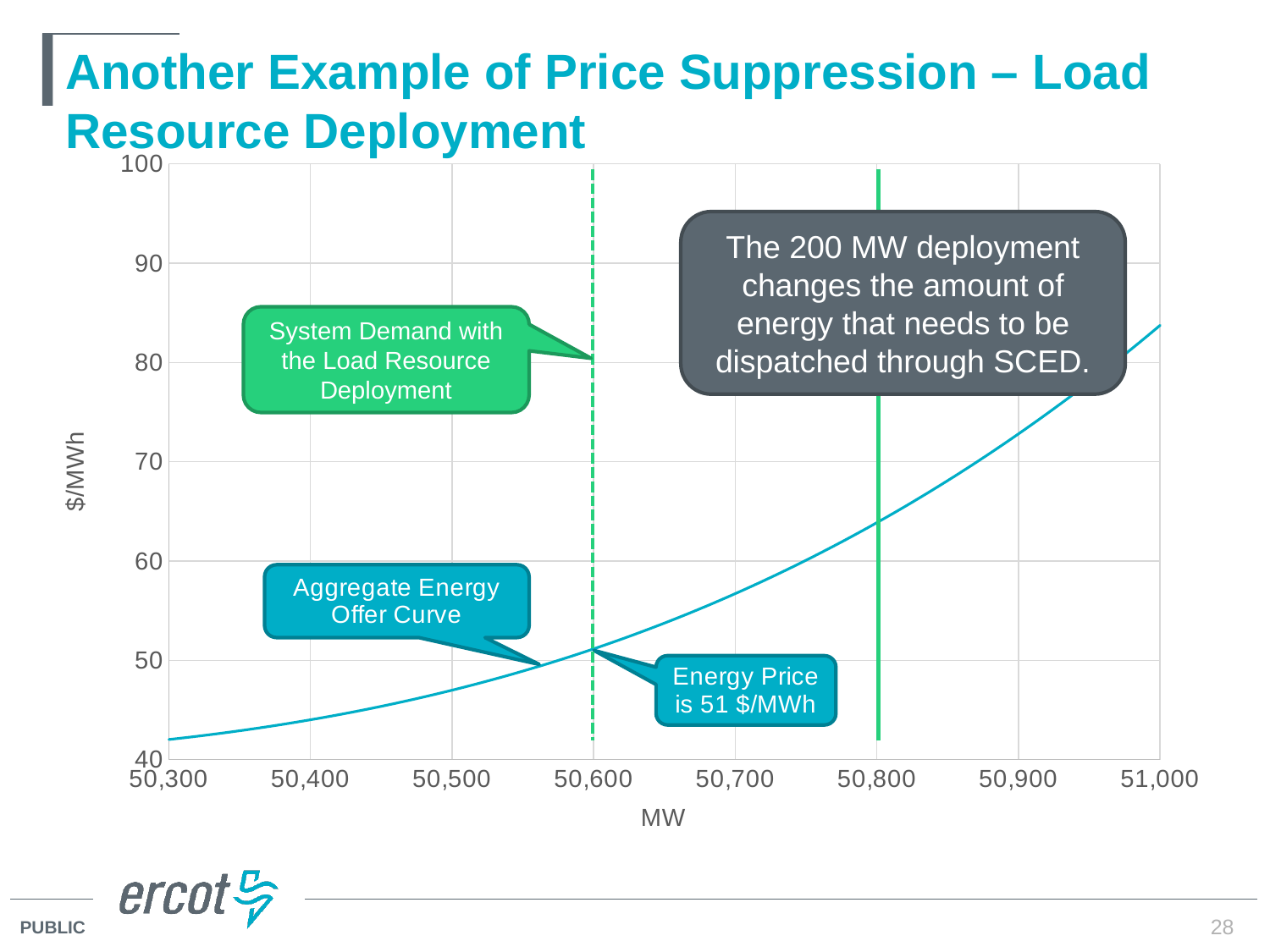
At what MW value is the solid green vertical line located? 50,800 Is the value of the Aggregate Energy Offer Curve at 50,300 MW greater or less than 50? less According to the callout, what is the energy price at the System Demand with the Load Resource Deployment? 51 $/MWh How many labelled tick marks are on the x axis? 8 What is the label of the y axis? $/MWh Does the Aggregate Energy Offer Curve rise or fall as MW increases along the x axis? rises Is the value of the Aggregate Energy Offer Curve at 50,800 MW greater or less than 60? greater What kind of chart is shown on the slide? line chart Is the value of the Aggregate Energy Offer Curve at 50,400 MW greater or less than 50? less At what MW value is the dashed vertical line for System Demand with the Load Resource Deployment located? 50,600 What is the label of the x axis? MW